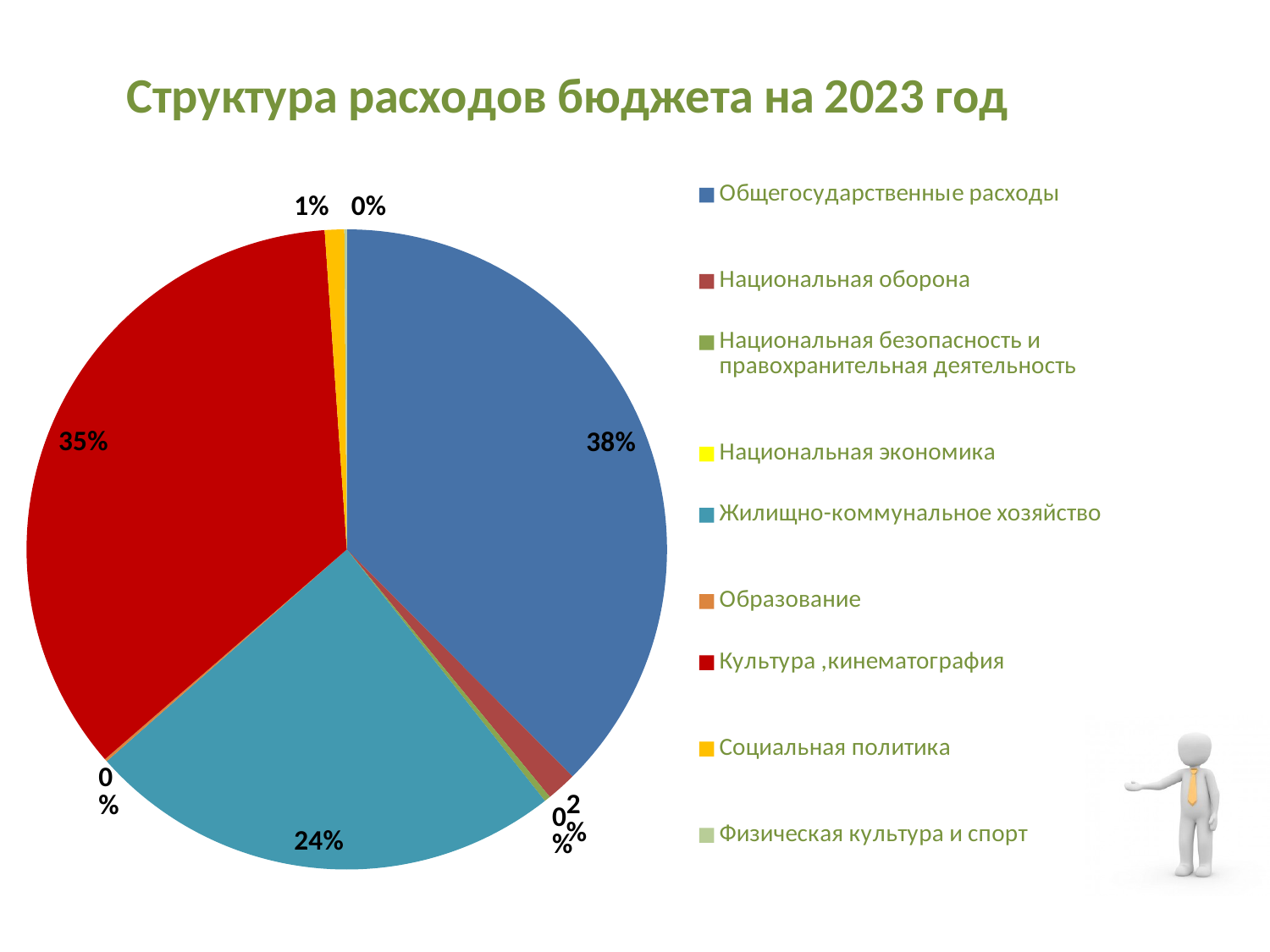
What share of the pie is Общегосударственные расходы? 38% What colour is the slice for Жилищно-коммунальное хозяйство? teal (blue-green) Which is larger, Культура ,кинематография or Жилищно-коммунальное хозяйство? Культура ,кинематография What kind of chart is shown on the slide? pie chart What is the value shown for Культура ,кинематография? 35% How many entries does the legend list? 9 What is the value shown for Социальная политика? 1% What is the value shown for Жилищно-коммунальное хозяйство? 24% What is the title of the chart? Структура расходов бюджета на 2023 год Which category has the largest share of the pie? Общегосударственные расходы What is the value shown for Национальная оборона? 2% What is the difference between the shares of Общегосударственные расходы and Культура ,кинематография? 3%